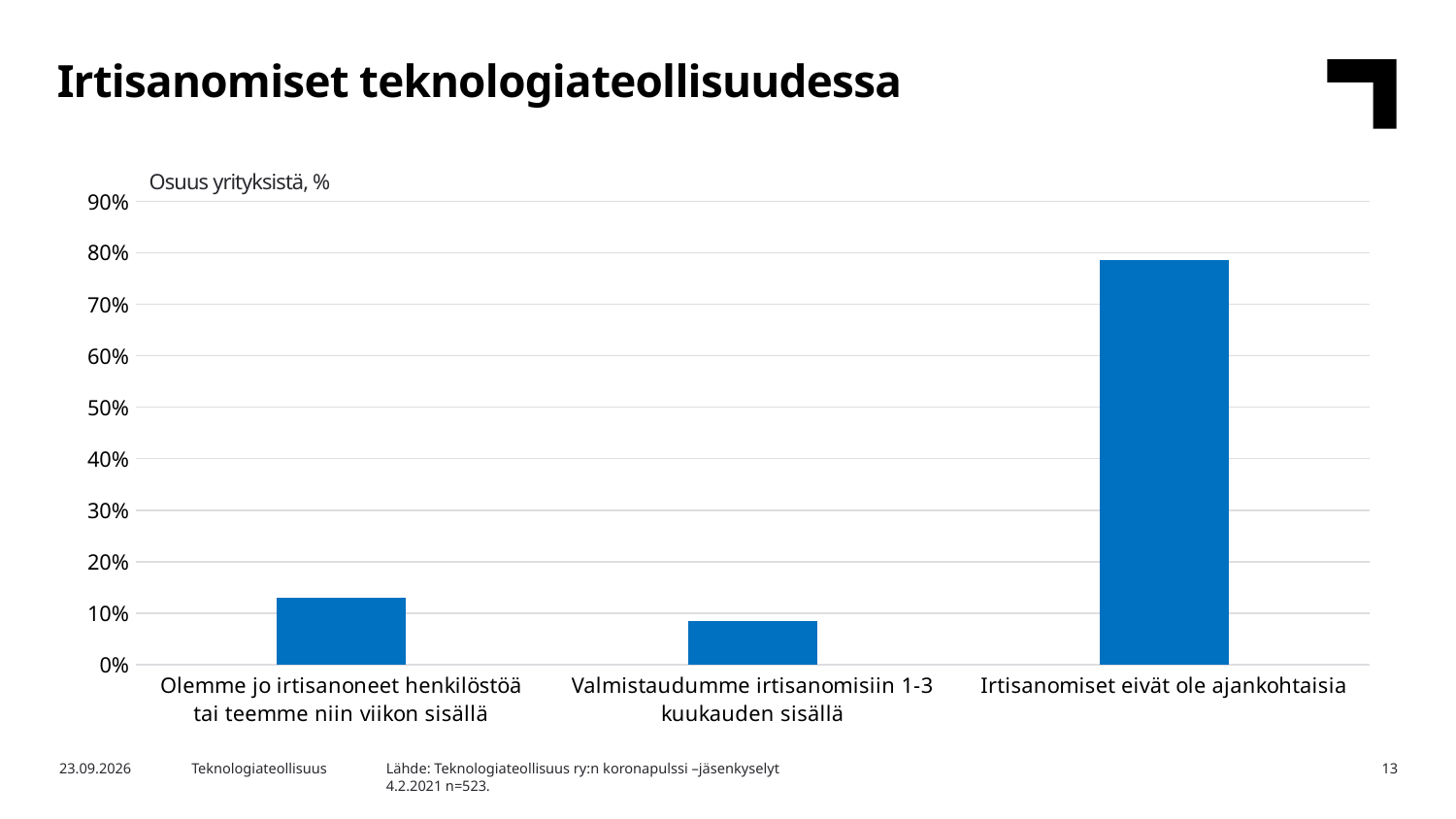
Is the value for "Olemme jo irtisanoneet henkilöstöä tai teemme niin viikon sisällä" greater or less than 10%? greater Which is larger: the value for "Olemme jo irtisanoneet henkilöstöä tai teemme niin viikon sisällä" or the value for "Valmistaudumme irtisanomisiin 1-3 kuukauden sisällä"? Olemme jo irtisanoneet henkilöstöä tai teemme niin viikon sisällä What is the title of the chart on the slide? Irtisanomiset teknologiateollisuudessa Which category has the highest value in the chart? Irtisanomiset eivät ole ajankohtaisia Is the value for "Irtisanomiset eivät ole ajankohtaisia" greater or less than 70%? greater What kind of chart is shown on the slide? bar chart Is the value for "Valmistaudumme irtisanomisiin 1-3 kuukauden sisällä" greater or less than 10%? less What is the highest value shown on the vertical axis of the chart? 90% What label is shown above the vertical axis of the chart? Osuus yrityksistä, % How many categories are shown on the x axis of the chart? 3 Which category has the lowest value in the chart? Valmistaudumme irtisanomisiin 1-3 kuukauden sisällä